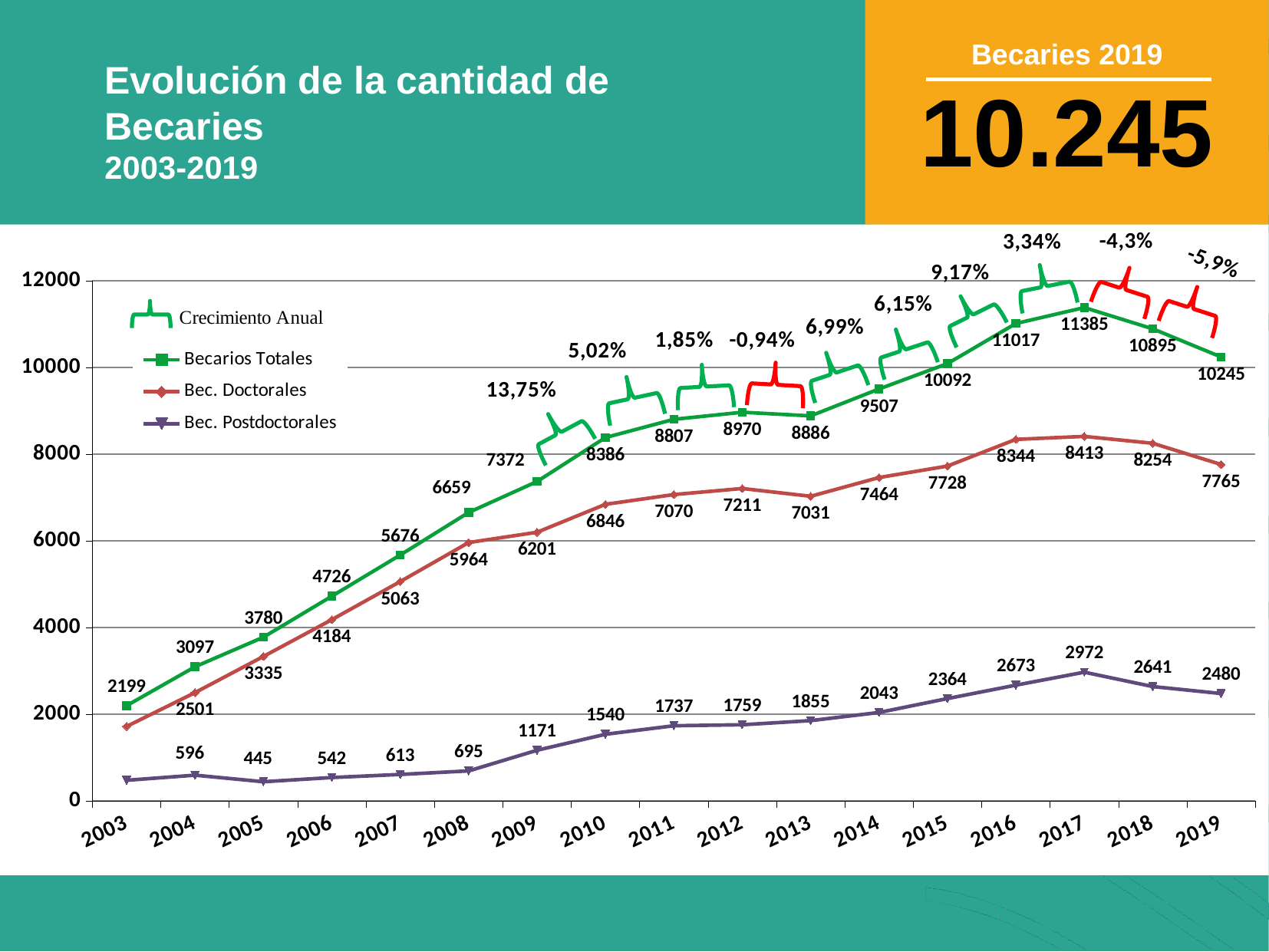
What kind of chart is shown on the slide? line chart How many data lines are plotted on the chart? 3 In which year is Becarios Totales highest? 2017 What is the value of Bec. Postdoctorales in 2005? 445 In which year is Becarios Totales lowest? 2003 Which is larger for Bec. Doctorales: the value in 2012 or in 2013? 2012 What is the value of Bec. Doctorales in 2019? 7765 How many years are shown on the x axis? 17 What is the value of Becarios Totales in 2017? 11385 Does Becarios Totales rise or fall from 2017 to 2019? fall Is the value for Bec. Doctorales in 2003 greater or less than 2000? less What is the difference between Becarios Totales in 2018 and 2019? 650